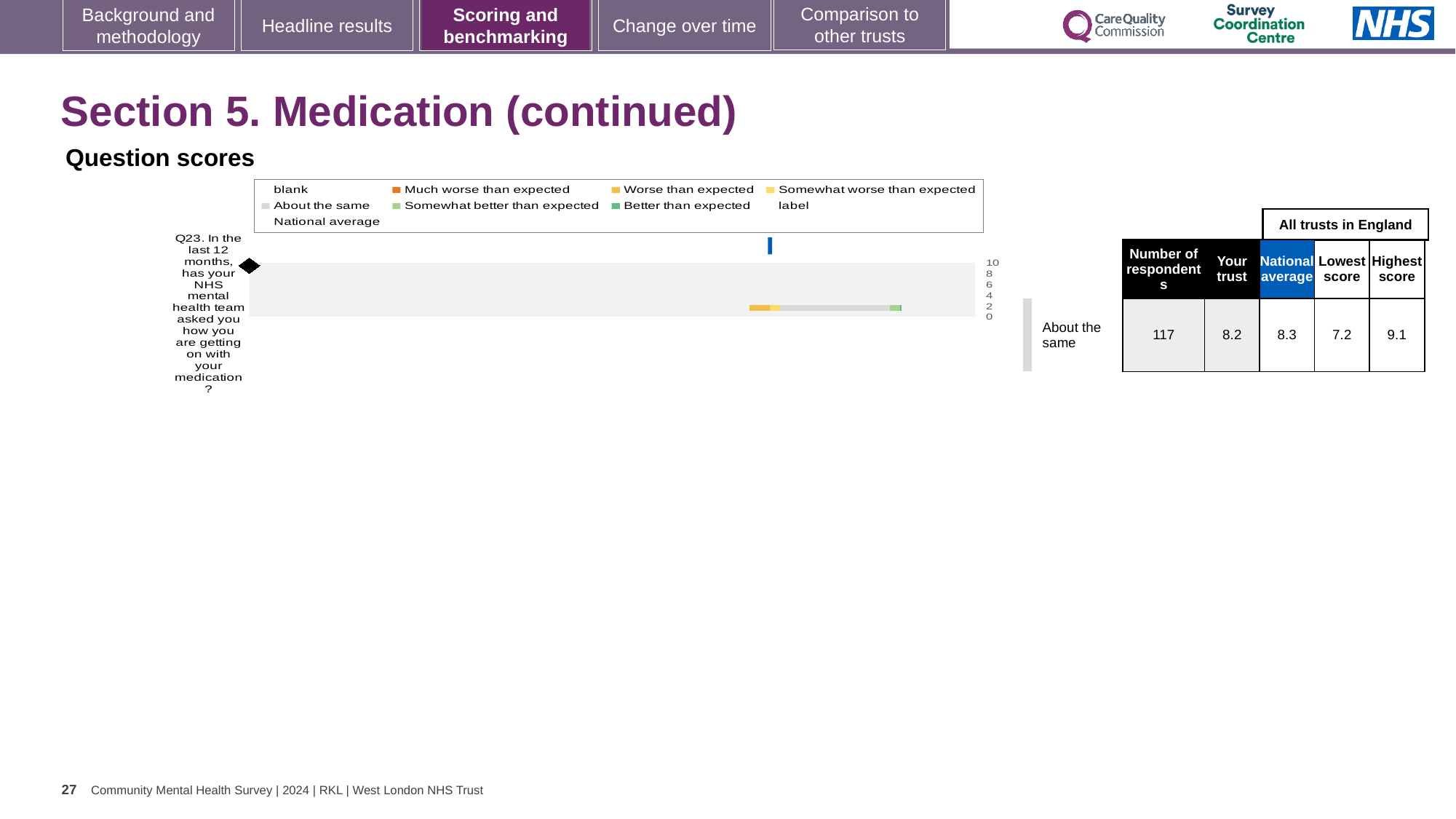
How many respondents answered Q23? 117 What is the highest score among all trusts in England for Q23? 9.1 How many survey questions are plotted in the chart? 1 What is the difference between the highest and lowest scores for Q23 across all trusts in England? 1.9 Which question is plotted in the chart? Q23. In the last 12 months, has your NHS mental health team asked you how you are getting on with your medication? Which is larger for Q23, the 'Your trust' score or the national average? National average What is the 'Your trust' score for Q23? 8.2 What kind of chart is shown under 'Question scores'? bar chart What is the difference between the national average and the 'Your trust' score for Q23? 0.1 What is the national average score for Q23? 8.3 What category label is shown next to the bar for Q23? About the same What is the lowest score among all trusts in England for Q23? 7.2